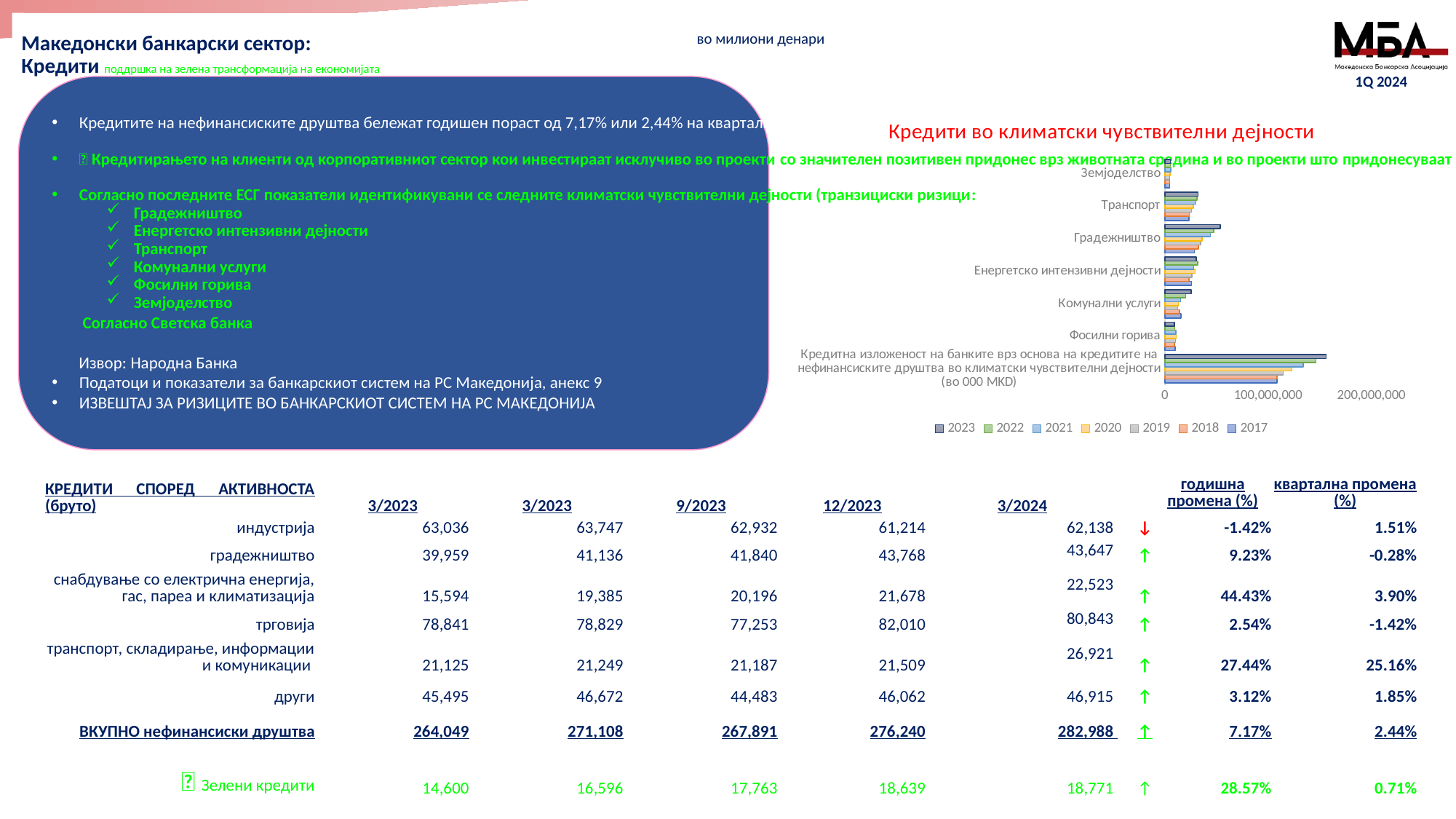
What kind of chart is shown under the title "Кредити во климатски чувствителни дејности"? bar chart In the chart "Кредити во климатски чувствителни дејности", which category has the longest bars? Кредитна изложеност на банките врз основа на кредитите на нефинансиските друштва во климатски чувствителни дејности (во 000 MKD) In the chart "Кредити во климатски чувствителни дејности", which has the larger 2023 value: Транспорт or Земјоделство? Транспорт In the chart "Кредити во климатски чувствителни дејности", is the 2023 value for Транспорт greater or less than 100,000,000? less In the chart "Кредити во климатски чувствителни дејности", which has the larger 2023 value: Градежништво or Фосилни горива? Градежништво How many categories are shown on the vertical axis of the chart "Кредити во климатски чувствителни дејности"? 7 In the chart "Кредити во климатски чувствителни дејности", is the 2023 value for the total credit exposure category (Кредитна изложеност...) greater or less than 100,000,000? greater In the chart "Кредити во климатски чувствителни дејности", which category has the shortest bars? Земјоделство Which years are listed in the legend of the chart "Кредити во климатски чувствителни дејности"? 2023, 2022, 2021, 2020, 2019, 2018, 2017 In the chart "Кредити во климатски чувствителни дејности", is the 2023 value for Градежништво greater or less than 100,000,000? less How many series does the legend of the chart "Кредити во климатски чувствителни дејности" list? 7 What is the highest tick value shown on the horizontal axis of the chart "Кредити во климатски чувствителни дејности"? 200,000,000